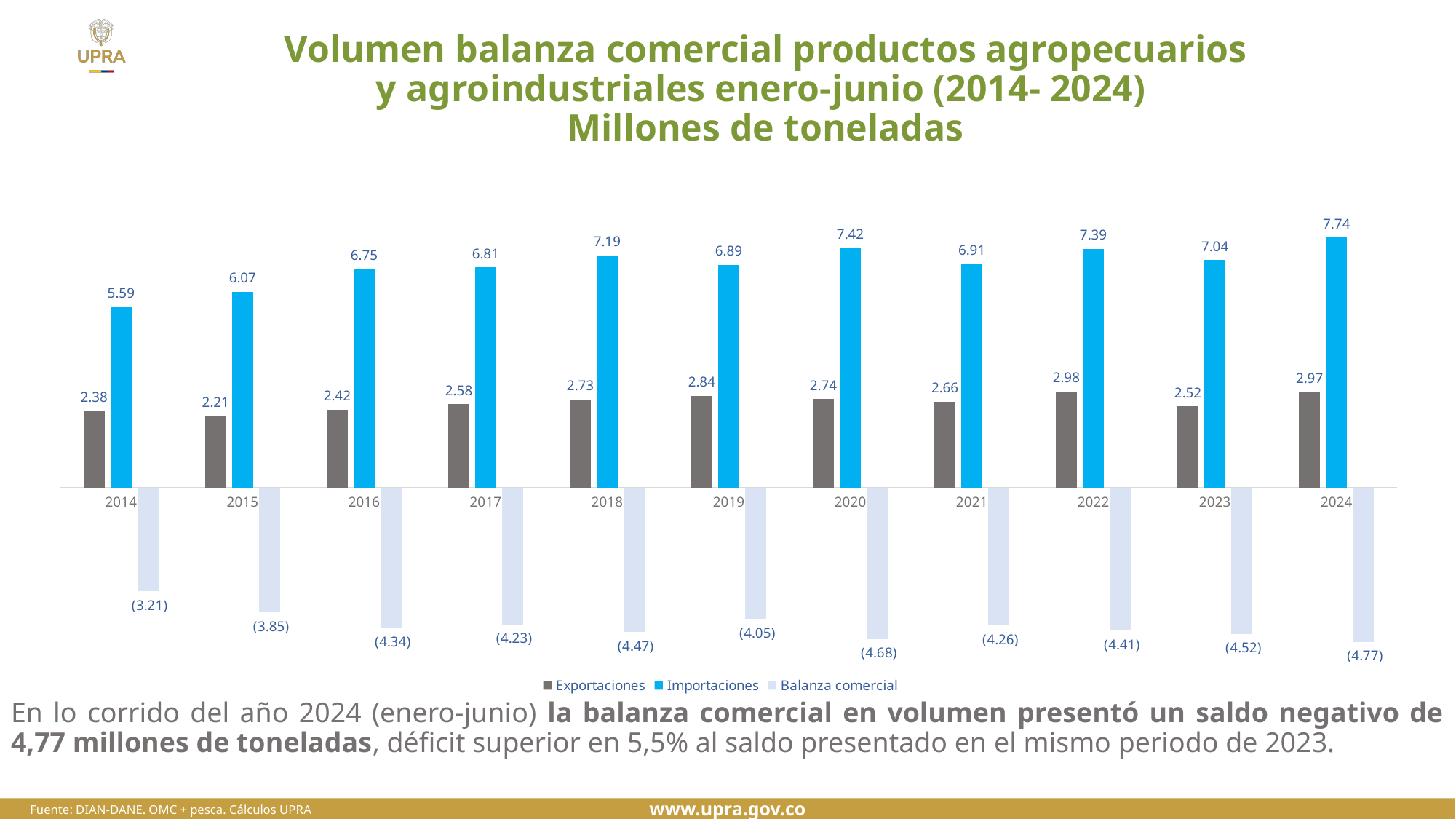
How many years are shown on the x axis? 11 What is the value of Balanza comercial for 2016? (4.34) Do the Importaciones values generally rise or fall from 2014 to 2024? Rise What is the value of Exportaciones for 2019? 2.84 How many series does the legend list? 3 Which year has the highest Importaciones value? 2024 What is the difference between Importaciones and Exportaciones in 2020? 4.68 What kind of chart is shown on the slide? Bar chart Which year has the lowest Exportaciones value? 2015 What is the value of Importaciones for 2024? 7.74 Which is larger, Exportaciones in 2022 or Exportaciones in 2023? Exportaciones in 2022